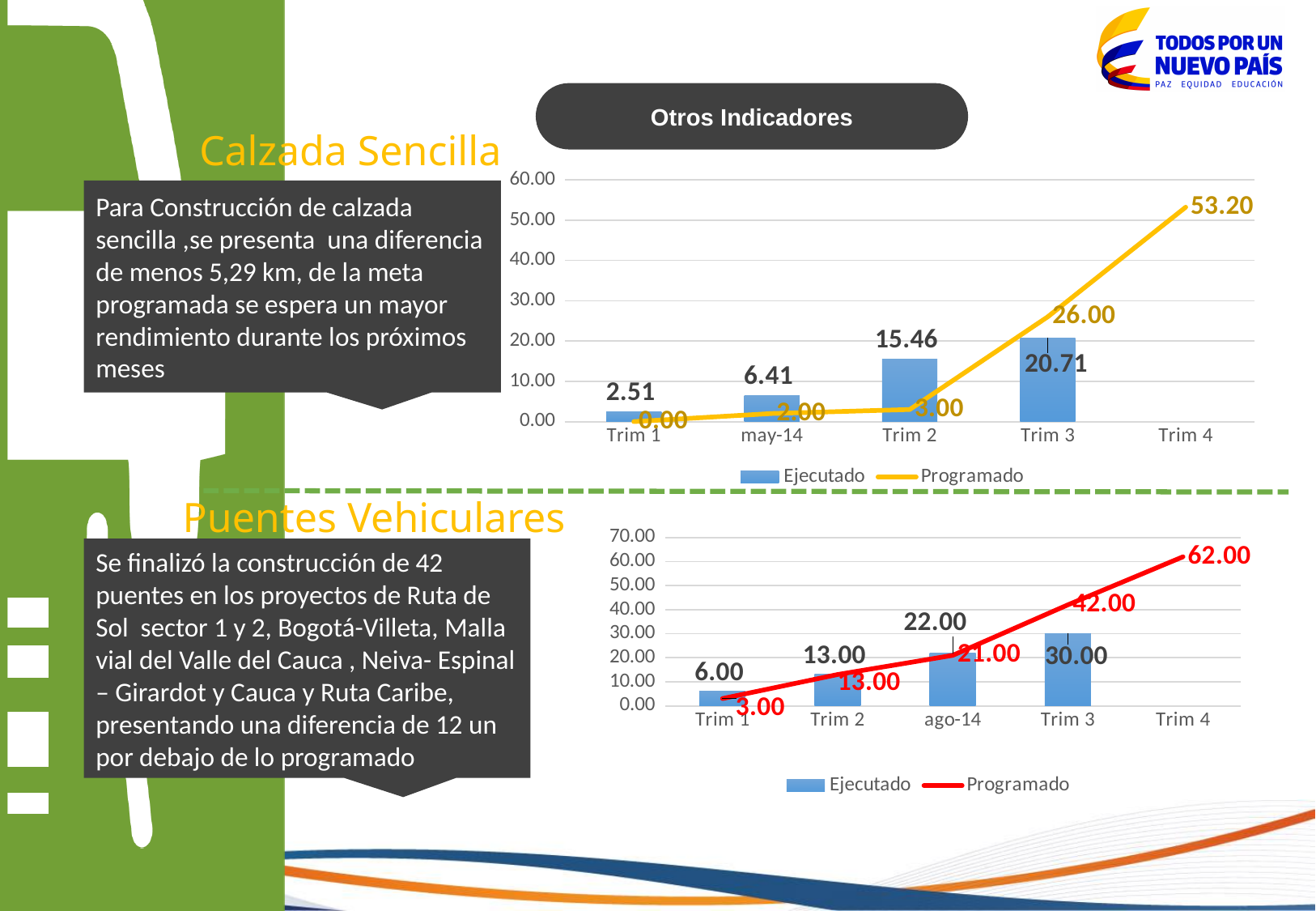
In the Calzada Sencilla chart, what is the Ejecutado value for Trim 2? 15.46 In the Puentes Vehiculares chart, how many categories are shown on the x axis? 5 In the Puentes Vehiculares chart, what is the Programado value for Trim 4? 62.00 What colour is the Programado line in the Puentes Vehiculares chart? Red In the Puentes Vehiculares chart, which is larger for Trim 3: the Ejecutado value or the Programado value? Programado In the Calzada Sencilla chart, which category has the highest Ejecutado value? Trim 3 In the Puentes Vehiculares chart, what is the difference between the Programado and Ejecutado values for Trim 3? 12.00 In the Calzada Sencilla chart, how many series does the legend list? 2 In the Calzada Sencilla chart, what is the Programado value for Trim 4? 53.20 In the Puentes Vehiculares chart, what is the Ejecutado value for ago-14? 22.00 In the Calzada Sencilla chart, does the Programado line rise or fall from Trim 1 to Trim 4? rise In the Calzada Sencilla chart, what is the difference between the Programado and Ejecutado values for Trim 3? 5.29